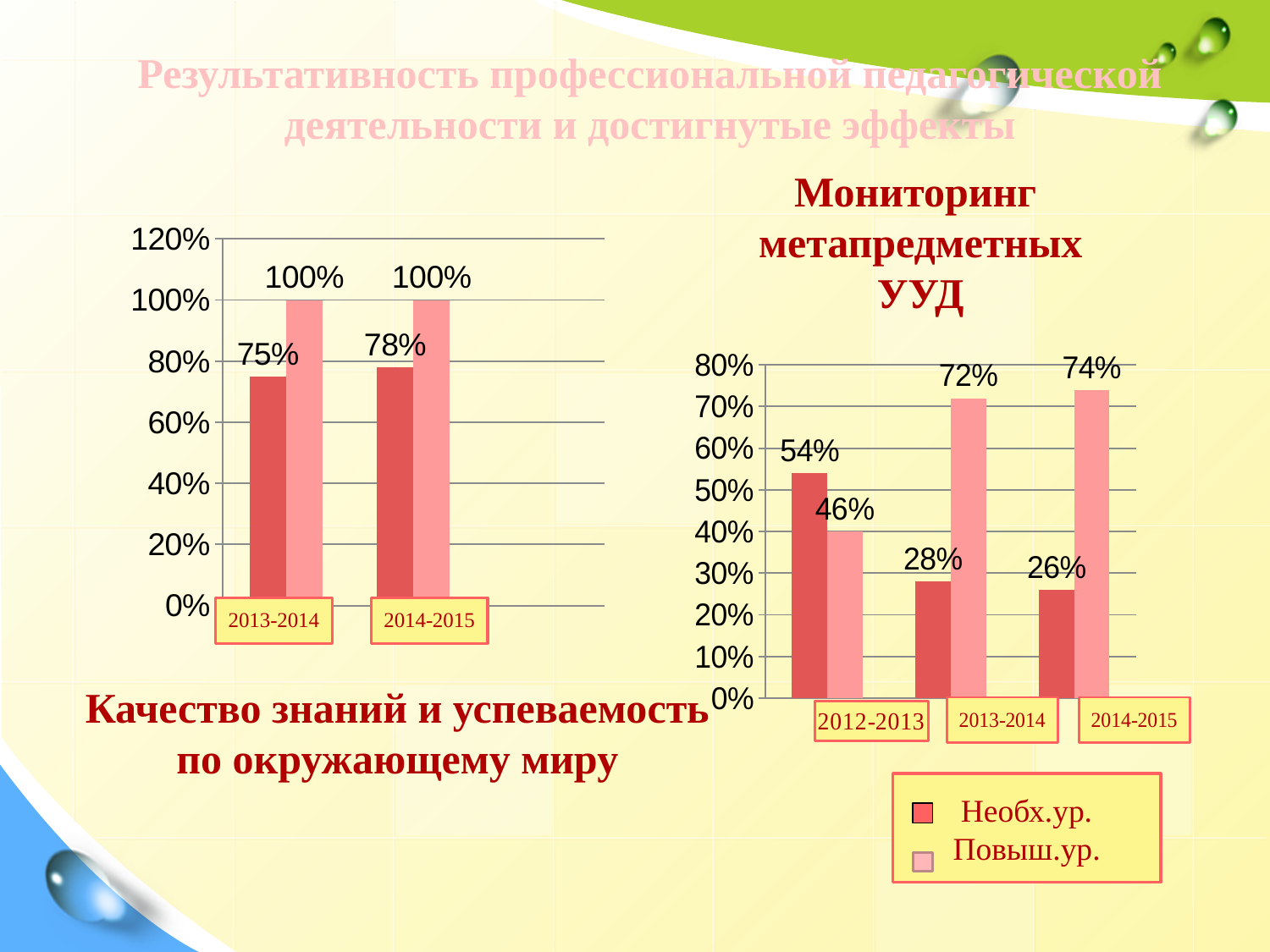
In the right chart (Мониторинг метапредметных УУД), does the value for Необх.ур. rise or fall from 2012-2013 to 2014-2015? fall In the right chart (Мониторинг метапредметных УУД), what is the value for Необх.ур. in 2012-2013? 54% In the right chart (Мониторинг метапредметных УУД), which is larger in 2012-2013: Необх.ур. or Повыш.ур.? Необх.ур. What kind of chart is the left chart (Качество знаний и успеваемость по окружающему миру)? bar chart In the right chart (Мониторинг метапредметных УУД), what is the value for Повыш.ур. in 2013-2014? 72% In the left chart (Качество знаний и успеваемость по окружающему миру), what is the difference between the pink bar and the dark red bar for 2013-2014? 25% In the right chart (Мониторинг метапредметных УУД), which year has the lowest value for Необх.ур.? 2014-2015 In the right chart (Мониторинг метапредметных УУД), what is the value for Повыш.ур. in 2014-2015? 74% In the right chart (Мониторинг метапредметных УУД), which year has the highest value for Повыш.ур.? 2014-2015 In the left chart (Качество знаний и успеваемость по окружающему миру), what is the value of the dark red bar for 2014-2015? 78% In the right chart (Мониторинг метапредметных УУД), what is the difference between Повыш.ур. and Необх.ур. in 2013-2014? 44% How many series does the legend of the right chart (Мониторинг метапредметных УУД) list? 2